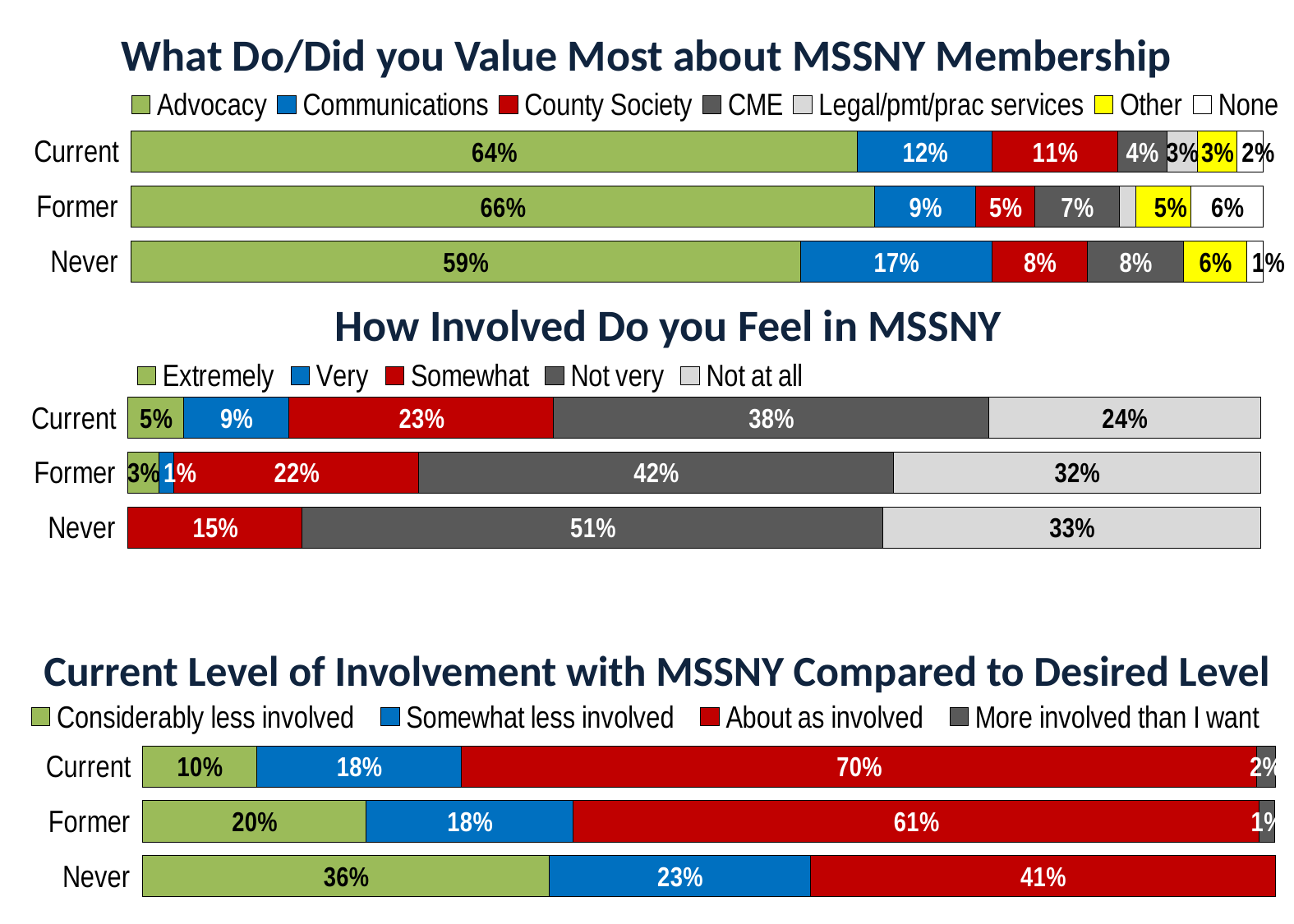
In the chart 'How Involved Do you Feel in MSSNY', is the Somewhat value larger for Current or Former members? Current In the chart 'Current Level of Involvement with MSSNY Compared to Desired Level', what percentage of Never members are Considerably less involved? 36% In the chart 'What Do/Did you Value Most about MSSNY Membership', what is the Communications value for Never members? 17% In the chart 'How Involved Do you Feel in MSSNY', how many groups are shown on the vertical axis? 3 In the chart 'Current Level of Involvement with MSSNY Compared to Desired Level', which group has the highest About as involved percentage? Current In the chart 'How Involved Do you Feel in MSSNY', what percentage of Never members answered Not very? 51% In the chart 'What Do/Did you Value Most about MSSNY Membership', which group has the highest Advocacy percentage? Former What kind of chart is 'Current Level of Involvement with MSSNY Compared to Desired Level'? Stacked bar chart In the chart 'What Do/Did you Value Most about MSSNY Membership', what is the difference between the County Society values for Current and Former members? 6% In the chart 'What Do/Did you Value Most about MSSNY Membership', what percentage of Current members chose Advocacy? 64% In the chart 'How Involved Do you Feel in MSSNY', which group has the lowest Not at all percentage? Current In the chart 'What Do/Did you Value Most about MSSNY Membership', how many series does the legend list? 7